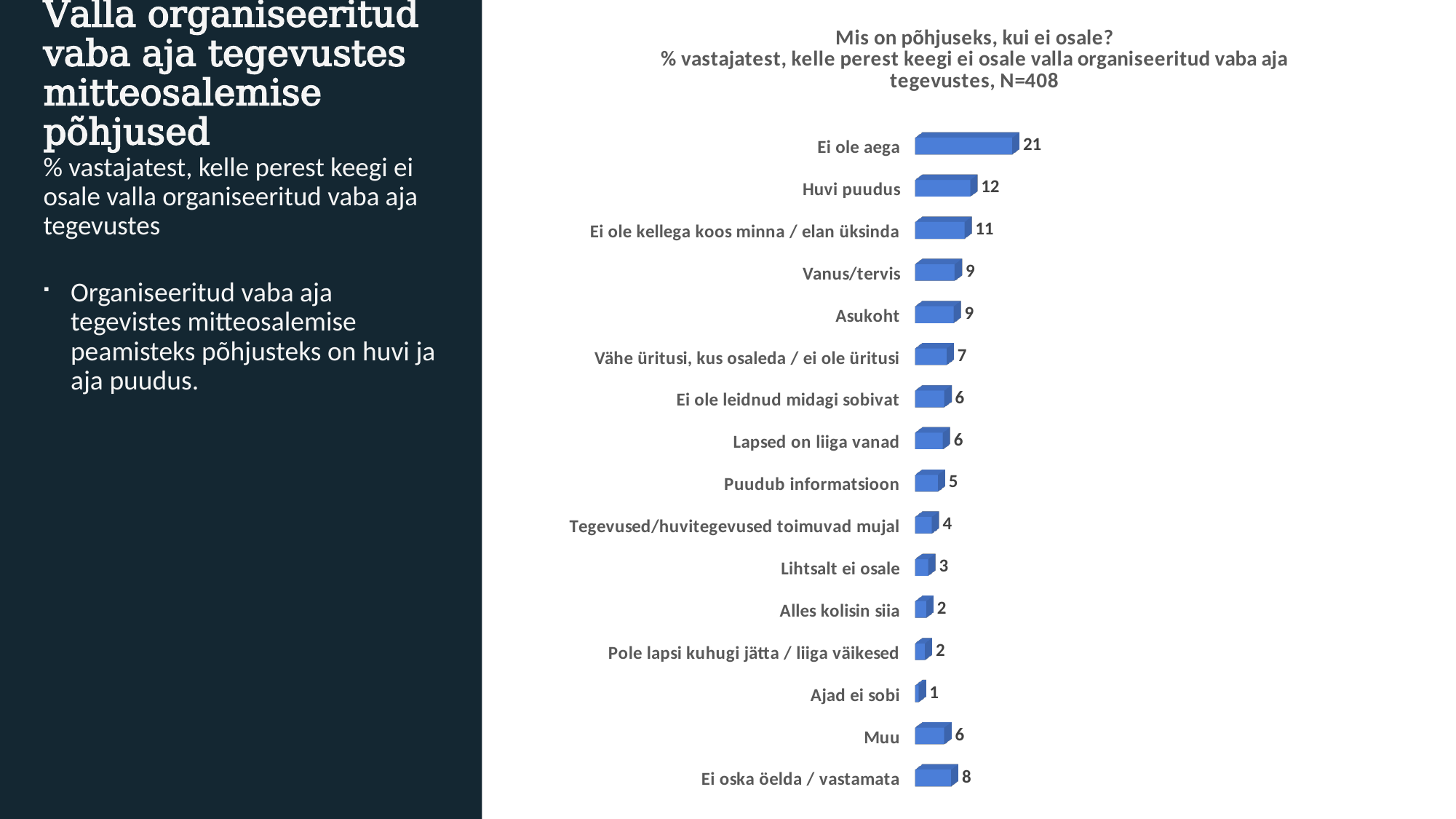
Which is larger, the value for "Vanus/tervis" or the value for "Vähe üritusi, kus osaleda / ei ole üritusi"? Vanus/tervis What kind of chart is shown on the slide? Bar chart What is the N value stated in the chart title? 408 What is the value for "Ei oska öelda / vastamata"? 8 Which category has the highest value? Ei ole aega What is the difference between the values for "Ei ole kellega koos minna / elan üksinda" and "Asukoht"? 2 How many categories are shown in the chart? 16 What is the value for "Ei ole aega"? 21 What is the value for "Huvi puudus"? 12 What is the value for "Puudub informatsioon"? 5 What is the difference between the values for "Ei ole aega" and "Huvi puudus"? 9 Which category has the lowest value? Ajad ei sobi